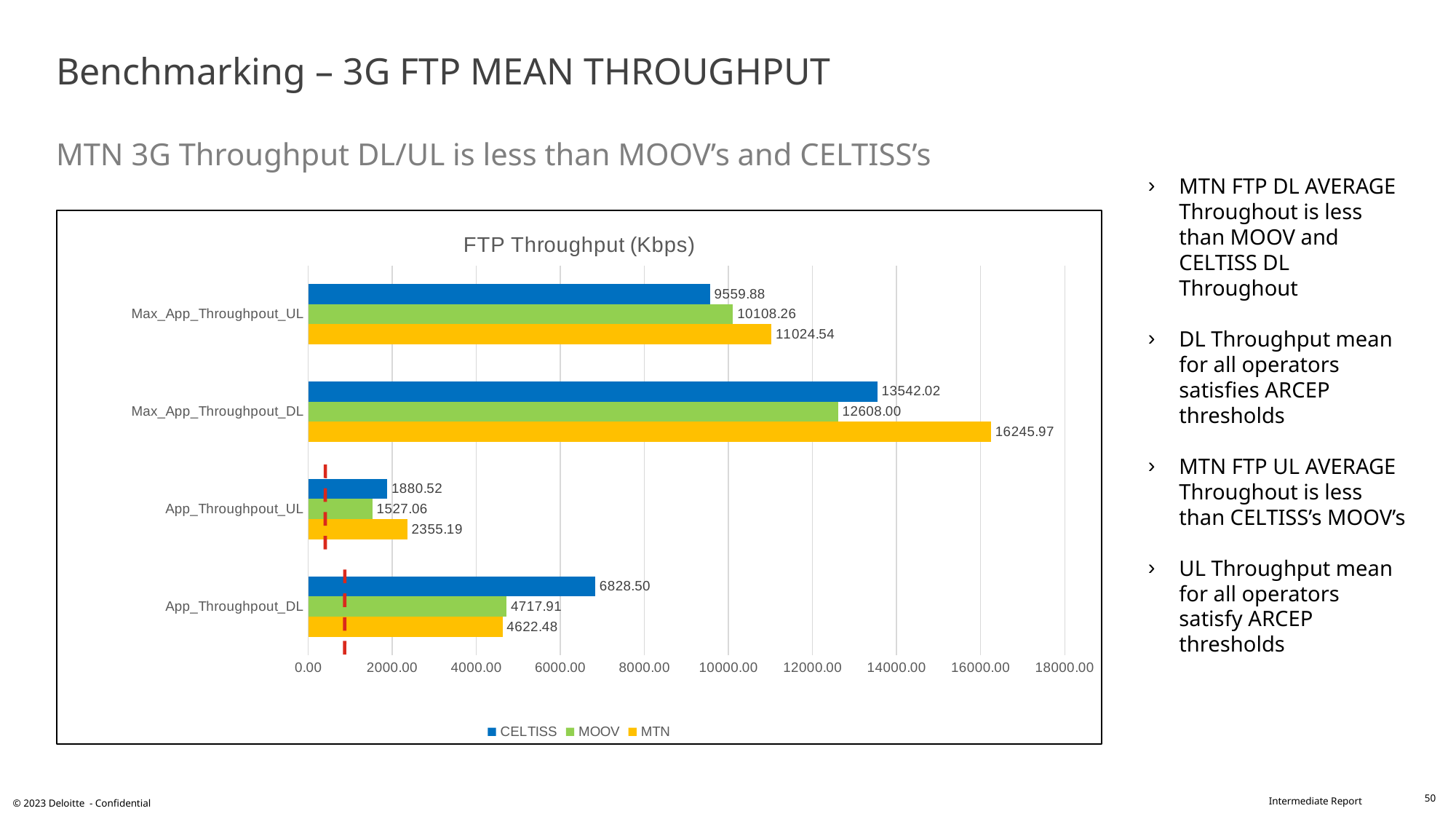
What is the MOOV value for App_Throughpout_UL? 1527.06 Which operator has the lowest value for App_Throughpout_DL? MTN What is the MTN value for Max_App_Throughpout_DL? 16245.97 What is the difference between the MTN and CELTISS values for Max_App_Throughpout_DL? 2703.95 What is the title of the chart? FTP Throughput (Kbps) Is the MOOV value for Max_App_Throughpout_DL greater or less than 14000.00? less What kind of chart is shown on the slide? Bar chart What is the CELTISS value for App_Throughpout_DL? 6828.50 How many series does the legend list? 3 Which is larger for App_Throughpout_UL, the CELTISS value or the MOOV value? CELTISS How many categories are shown on the chart? 4 Which operator has the highest value for Max_App_Throughpout_UL? MTN